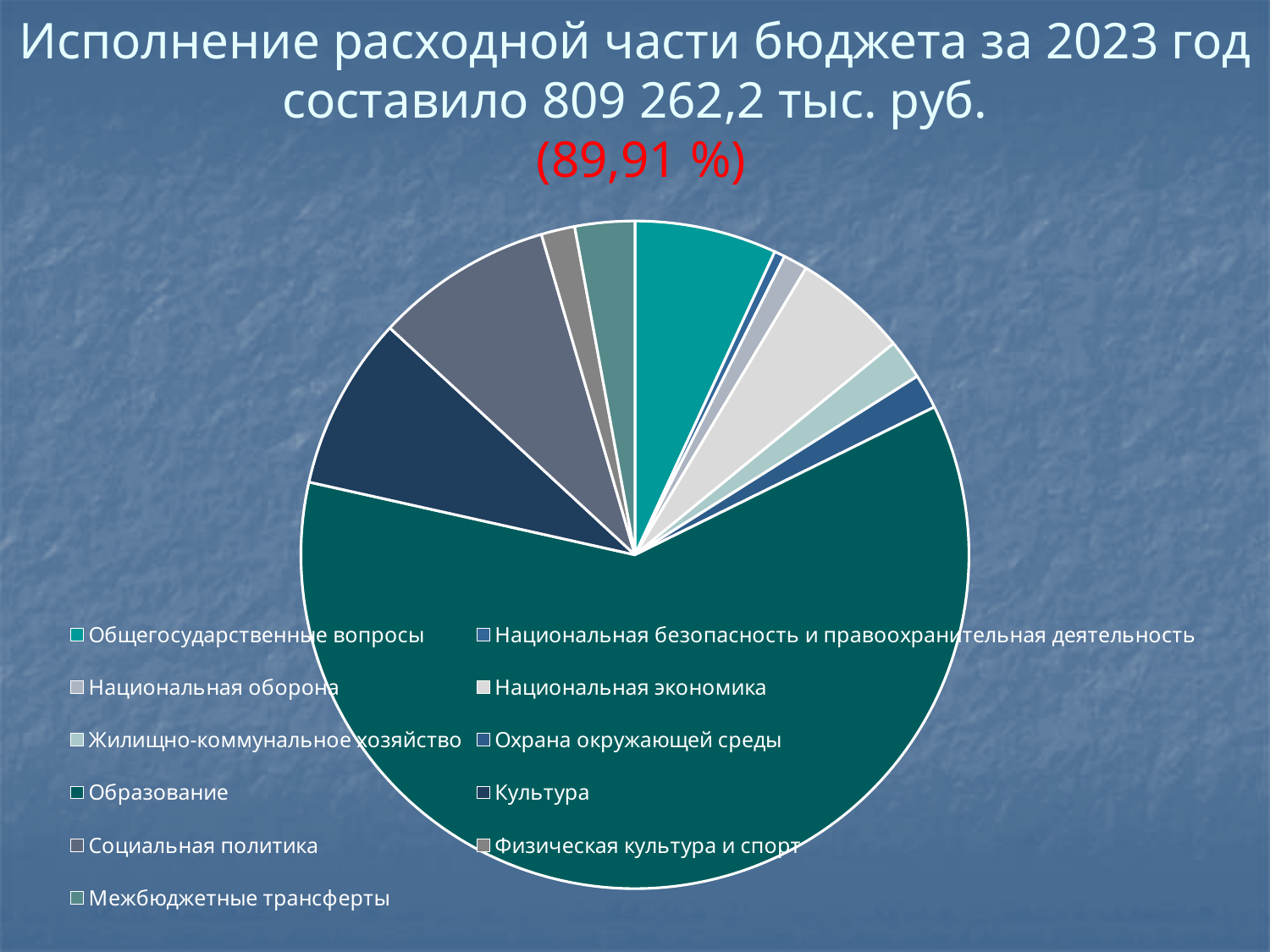
Which slice is larger: Образование or Социальная политика? Образование How many categories does the legend of the pie chart list? 11 Which slice is larger: Национальная экономика or Физическая культура и спорт? Национальная экономика Which category has the largest slice of the pie chart? Образование What percentage is shown in red in the slide title? 89,91 % According to the slide title, what was the total budget expenditure execution for 2023? 809 262,2 тыс. руб. Which slice is larger: Общегосударственные вопросы or Национальная безопасность и правоохранительная деятельность? Общегосударственные вопросы What kind of chart is shown on the slide? pie chart